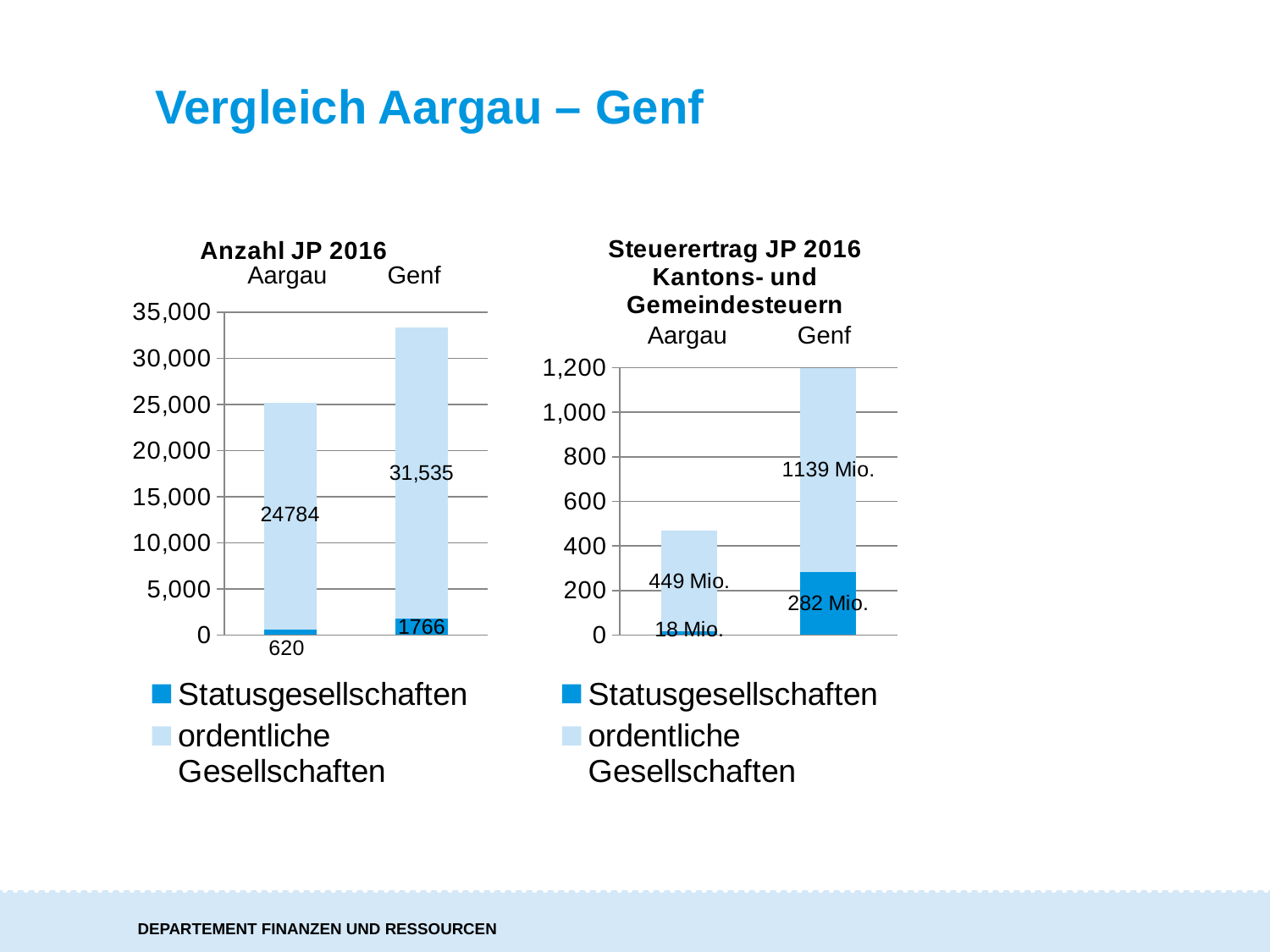
What kind of chart is the 'Steuerertrag JP 2016' chart? Stacked bar chart In the 'Steuerertrag JP 2016' chart, what is the value for Statusgesellschaften in Genf? 282 Mio. In the 'Anzahl JP 2016' chart, what is the total of the stacked bar for Genf? 33,301 How many series does the legend of the 'Anzahl JP 2016' chart list? 2 In the 'Anzahl JP 2016' chart, what is the difference between the ordentliche Gesellschaften values for Genf and Aargau? 6,751 In the 'Anzahl JP 2016' chart, what is the value for ordentliche Gesellschaften in Aargau? 24784 In the 'Steuerertrag JP 2016' chart, what is the total of the stacked bar for Aargau? 467 Mio. In the 'Steuerertrag JP 2016' chart, which canton has the higher value for Statusgesellschaften? Genf In the 'Steuerertrag JP 2016' chart, is the total bar for Aargau greater or less than 600? less In the 'Steuerertrag JP 2016' chart, what is the value for ordentliche Gesellschaften in Aargau? 449 Mio. In the 'Anzahl JP 2016' chart, what is the value for Statusgesellschaften in Aargau? 620 In the 'Anzahl JP 2016' chart, what is the value for Statusgesellschaften in Genf? 1766